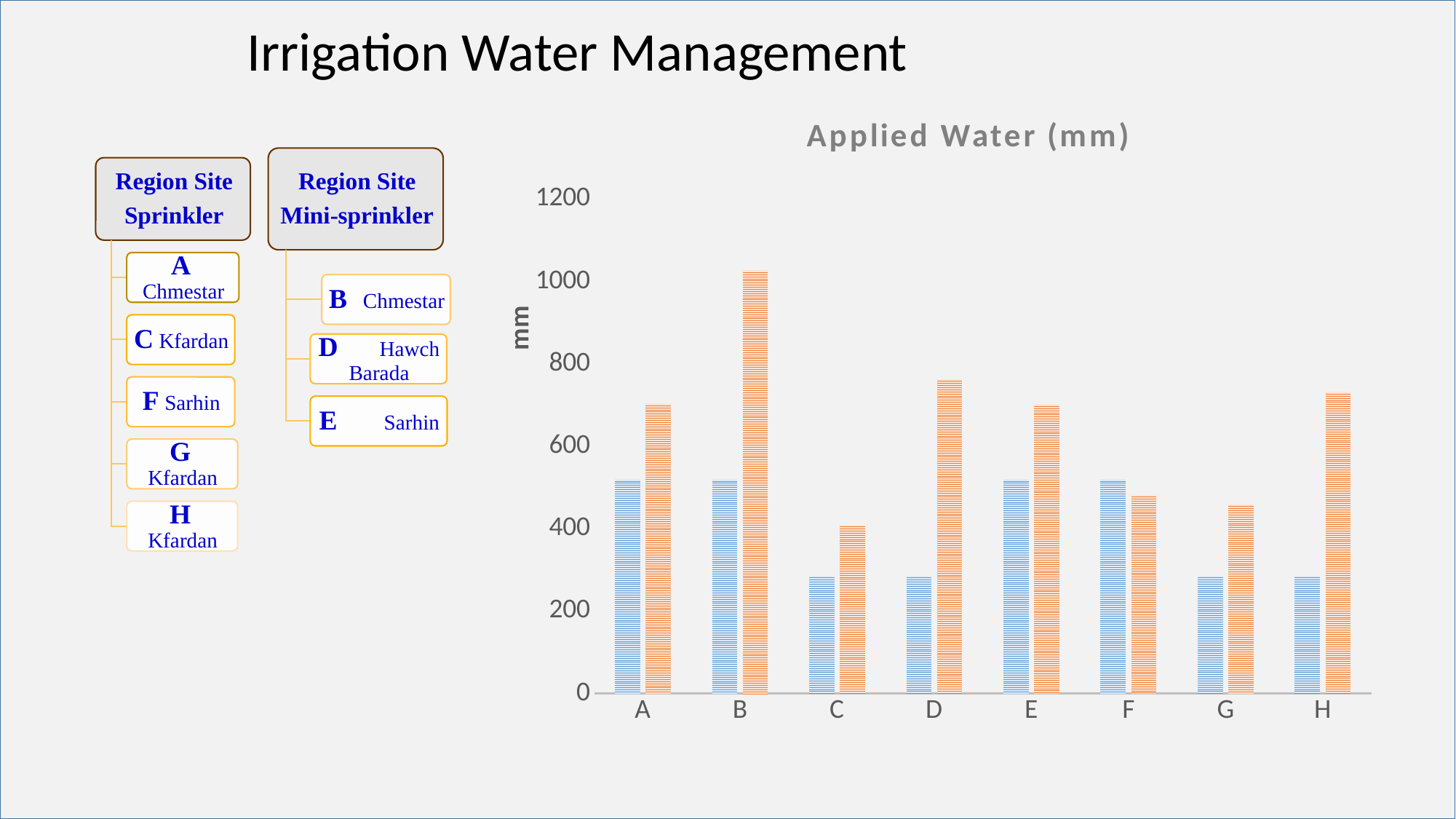
Is the orange bar for B greater or less than 800? greater How many categories are shown on the x axis of the chart? 8 What is the label on the vertical axis of the chart? mm Is the orange bar for D greater or less than 600? greater Is the blue bar for A greater or less than 600? less Which is larger for category A, the blue bar or the orange bar? the orange bar What kind of chart is shown on the slide? bar chart Which is larger, the orange bar for B or the orange bar for A? the orange bar for B What is the title of the chart? Applied Water (mm) Which category has the tallest orange bar in the chart? B Which category has the shortest orange bar in the chart? C